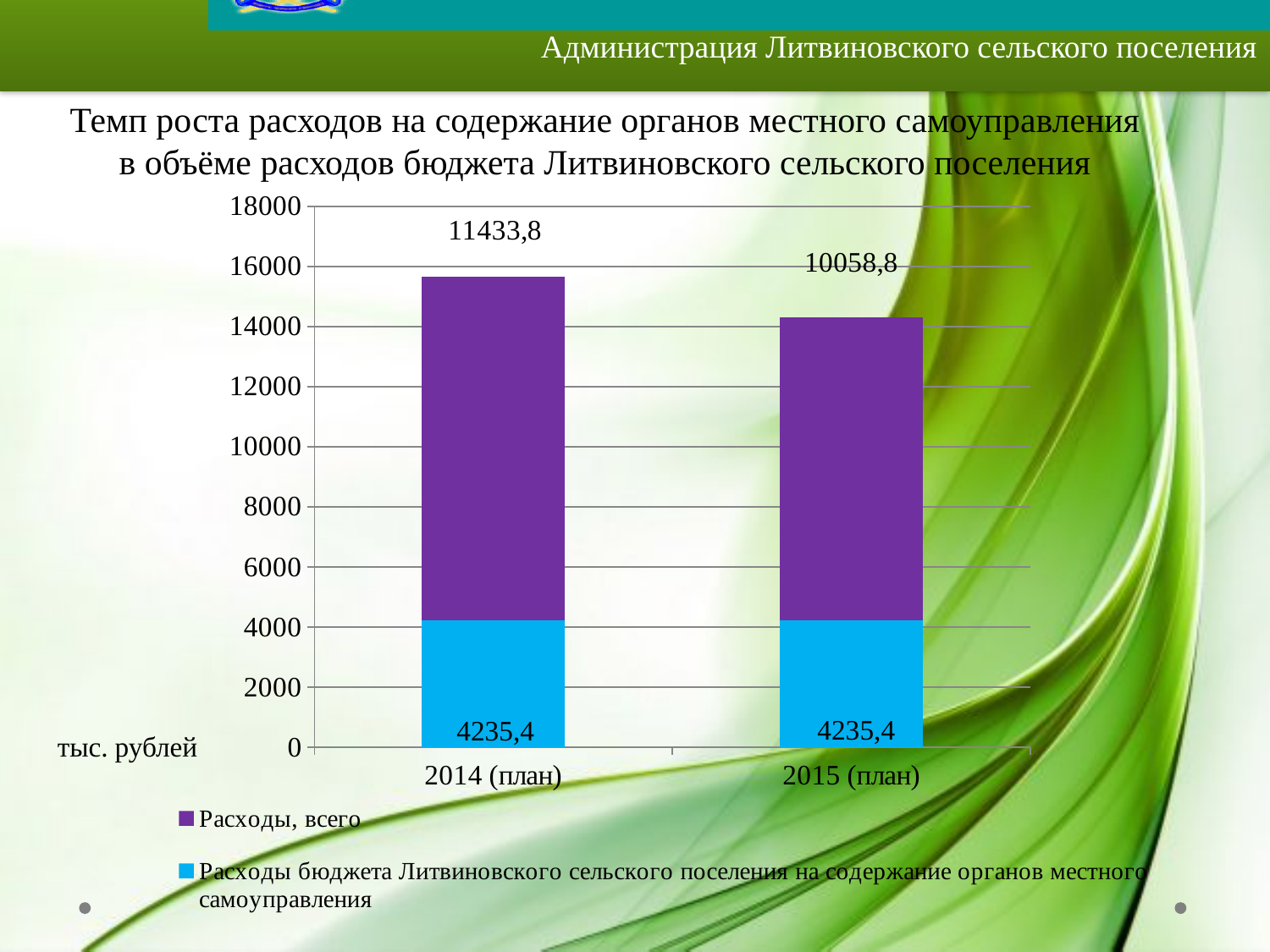
What is the difference between the 'Расходы, всего' values for 2014 (план) and 2015 (план)? 1375 What kind of chart is shown on the slide? Stacked bar chart What is the value of the 'Расходы бюджета Литвиновского сельского поселения на содержание органов местного самоуправления' series for 2015 (план)? 4235,4 Which category has the higher value for the 'Расходы, всего' series, 2014 (план) or 2015 (план)? 2014 (план) What is the value of the 'Расходы, всего' series for 2014 (план)? 11433,8 How many series does the legend list? 2 What is the total of the stacked bar for 2014 (план)? 15669,2 How many categories are shown on the x axis? 2 What is the value of the 'Расходы бюджета Литвиновского сельского поселения на содержание органов местного самоуправления' series for 2014 (план)? 4235,4 What unit label is shown next to the vertical axis? тыс. рублей What is the value of the 'Расходы, всего' series for 2015 (план)? 10058,8 What is the total of the stacked bar for 2015 (план)? 14294,2